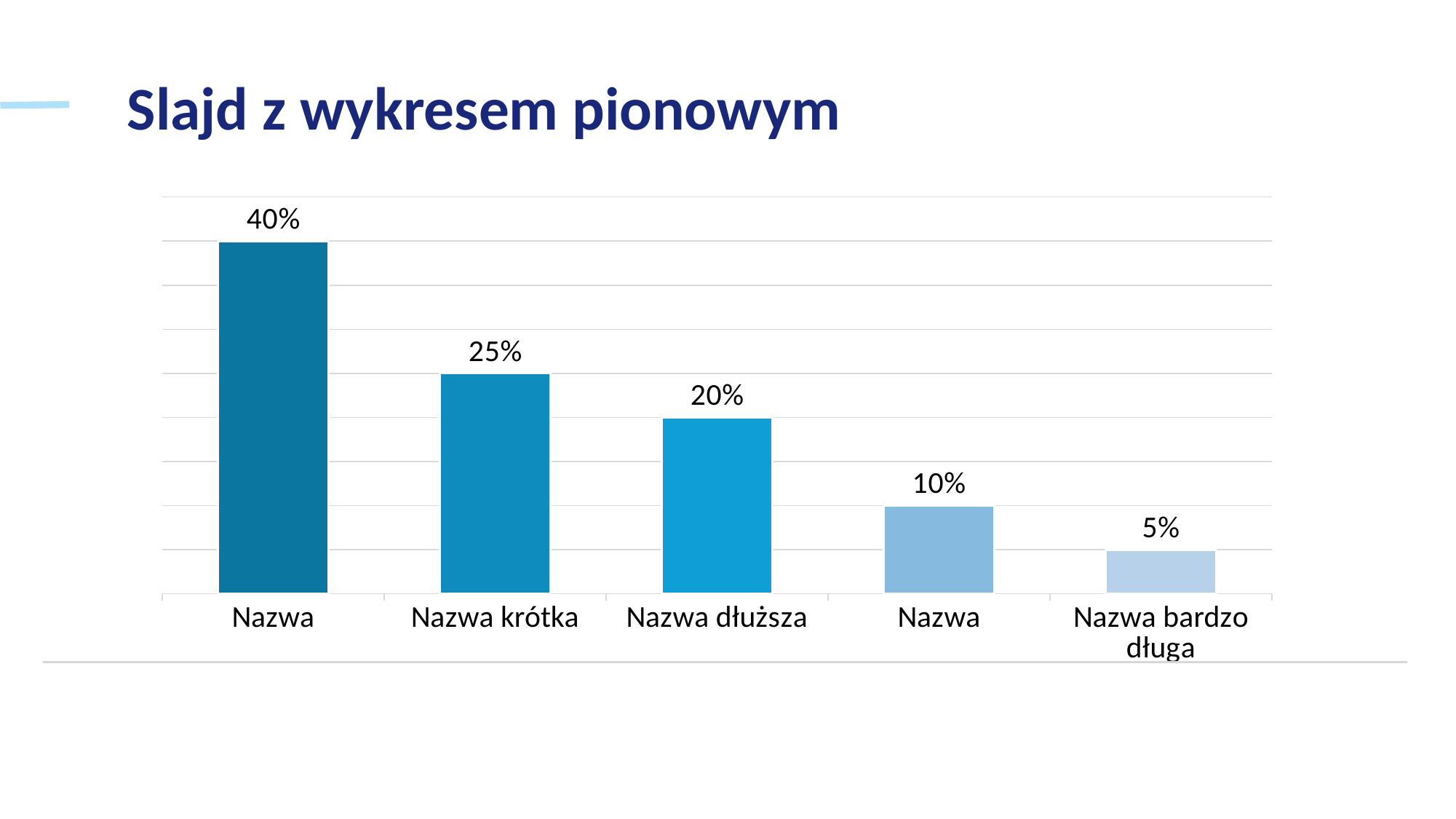
Which category has the lowest value? Nazwa bardzo długa What is the value of the first bar, labelled Nazwa? 40% What is the difference between the first bar (40%) and the last bar, Nazwa bardzo długa? 35% What is the value of the fourth bar, labelled Nazwa? 10% Which is larger, the value for Nazwa krótka or the value for Nazwa bardzo długa? Nazwa krótka What is the value for Nazwa dłuższa? 20% What kind of chart is shown on the slide? Bar chart Do the values rise or fall from left to right along the x axis? Fall What is the difference between the values for Nazwa krótka and Nazwa dłuższa? 5% How many bars does the chart show? 5 What is the value for Nazwa bardzo długa? 5% What is the value for Nazwa krótka? 25%